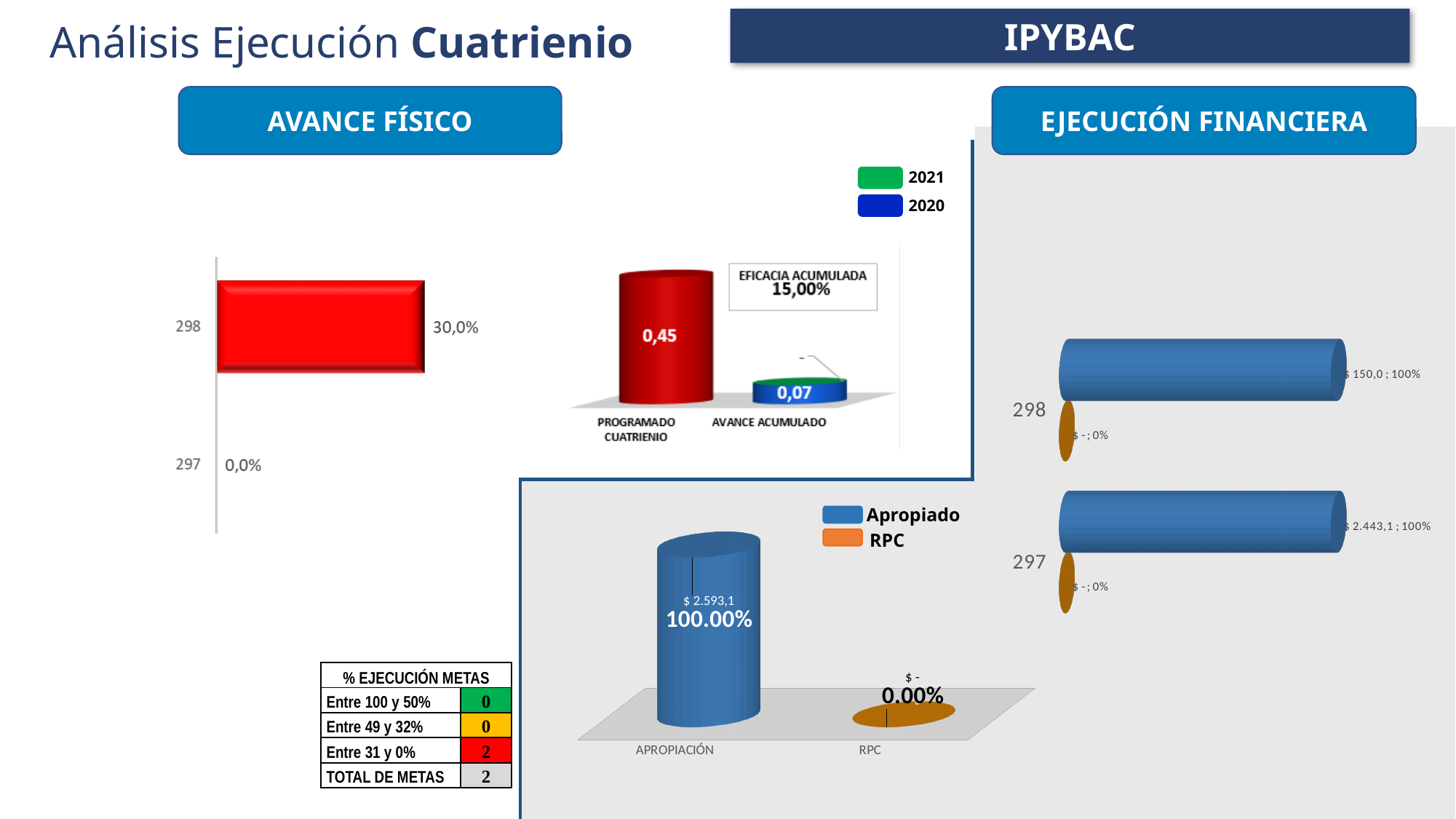
In the Avance Físico bar chart on the left, what is the value for category 298? 30,0% In the cylinder chart in the middle of the slide, what is the difference between Programado Cuatrienio and Avance Acumulado? 0,38 In the Avance Físico bar chart on the left, how many categories are shown? 2 In the bottom-center chart, what percentage is shown for RPC? 0.00% In the cylinder chart in the middle of the slide, what is the value for Programado Cuatrienio? 0,45 In the Ejecución Financiera chart on the right, what is the Apropiado value for category 297? $ 2.443,1 In the cylinder chart in the middle of the slide, what Eficacia Acumulada value is shown? 15,00% In the cylinder chart in the middle of the slide, what is the value for Avance Acumulado? 0,07 In the Avance Físico bar chart on the left, what is the value for category 297? 0,0% In the Avance Físico bar chart on the left, what kind of chart is it? Bar chart In the bottom-center chart, what is the value for Apropiación? $ 2.593,1 In the Avance Físico bar chart on the left, which category has the highest value? 298